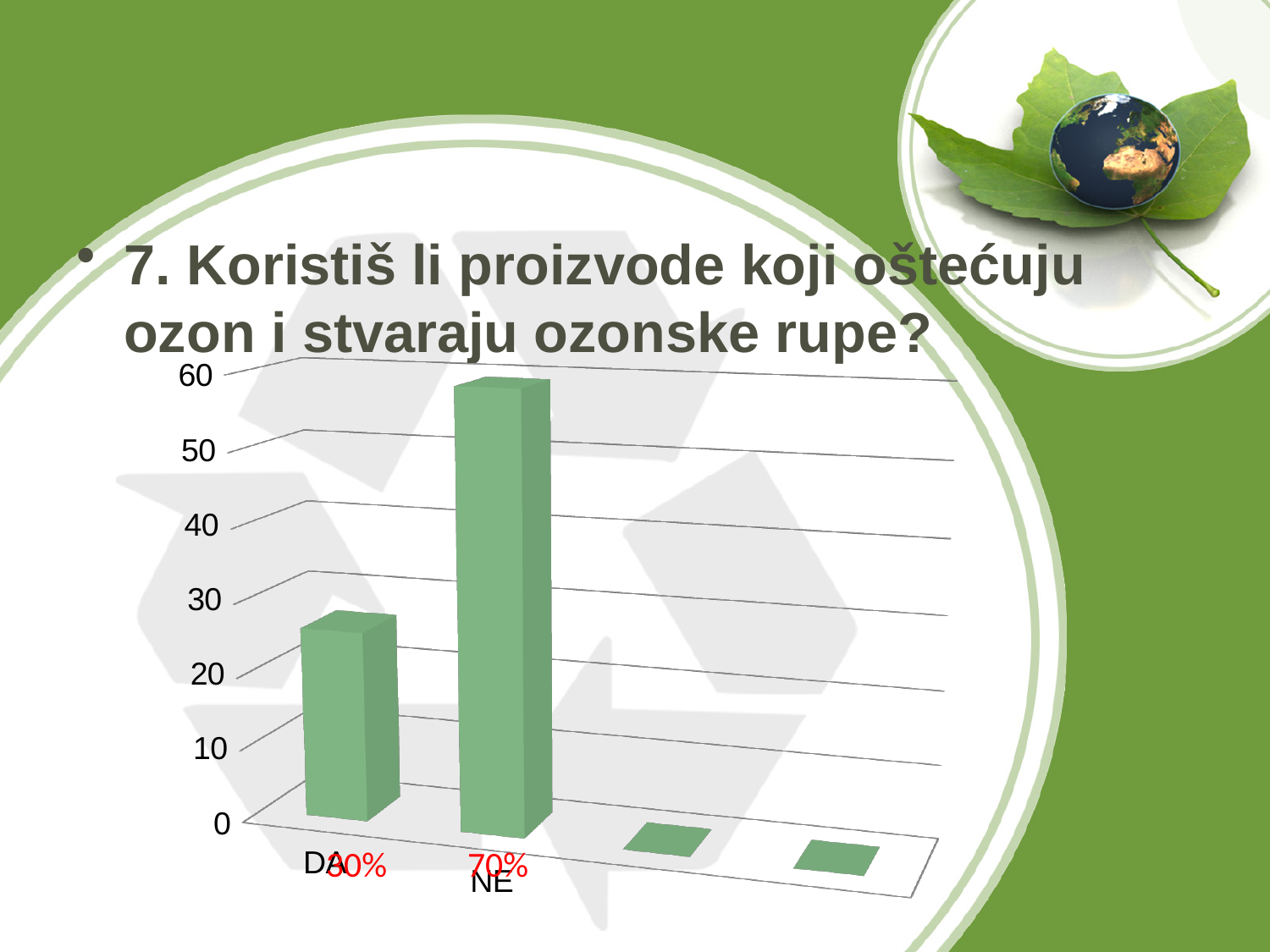
What colour are the bars in the chart? green Is the value for DA greater or less than 20? greater Which bar is taller, DA or NE? NE Which category has the lowest bar, DA or NE? DA Is the value for DA greater or less than 40? less What is the highest value shown on the vertical axis of the chart? 60 What kind of chart is shown on the slide? bar chart Which category has the highest bar, DA or NE? NE How many categories are labelled on the x axis of the chart? 2 Do the bar values rise or fall going from DA to NE? rise Is the value for NE greater or less than 50? greater